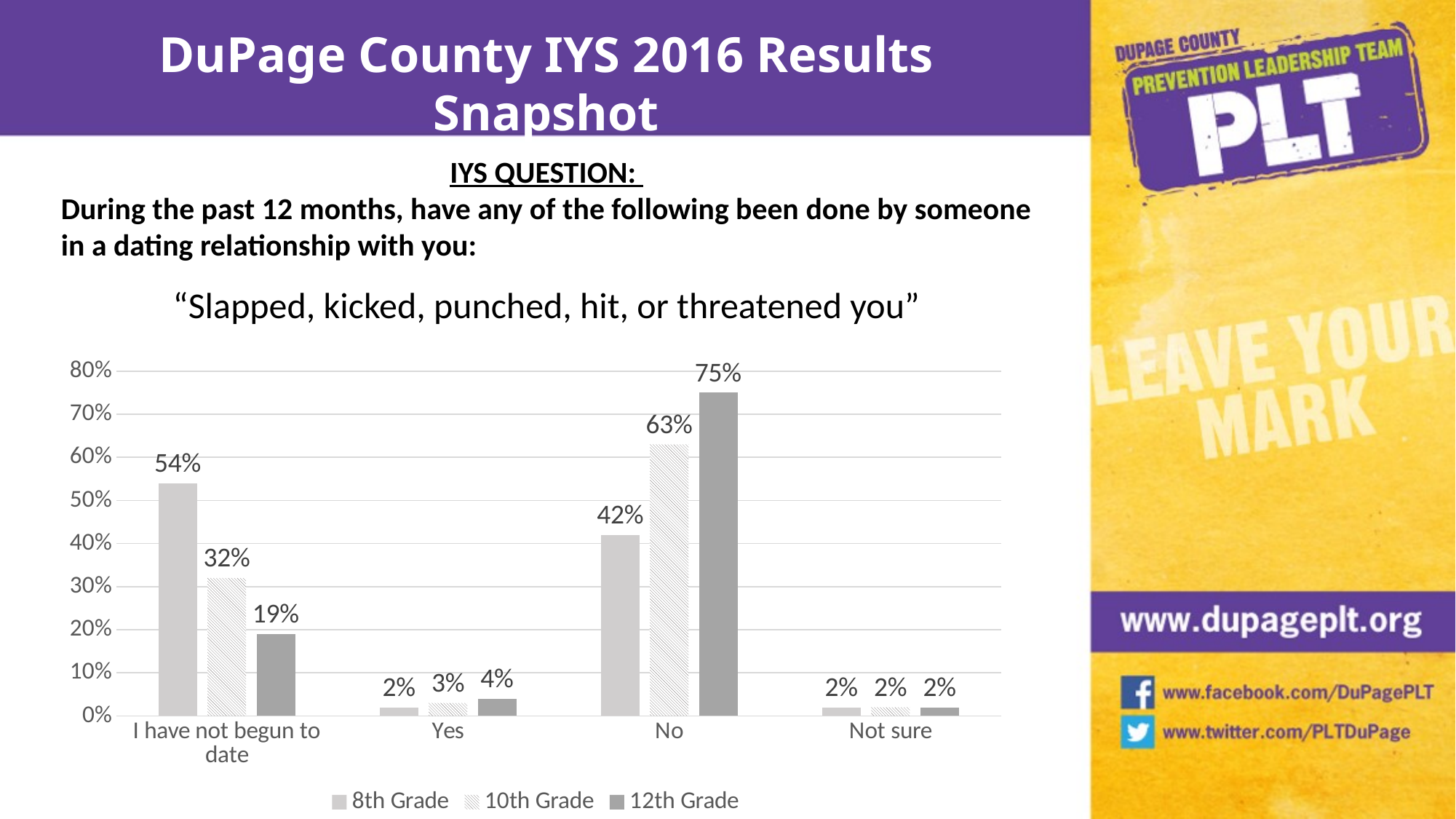
What is the value for 8th Grade in the "I have not begun to date" category? 54% What is the difference between the 12th Grade and 8th Grade values in the "No" category? 33% Which is larger in the "I have not begun to date" category: 8th Grade or 10th Grade? 8th Grade Is the value for 10th Grade in the "No" category greater or less than 50%? greater What kind of chart is shown on the slide? Bar chart How many series does the legend list? 3 How many categories are shown on the x axis? 4 Which category has the highest value for 12th Grade? No Which category has the lowest value for 8th Grade? Yes and Not sure (both 2%) What is the title of the chart? "Slapped, kicked, punched, hit, or threatened you" What is the value for 10th Grade in the "Yes" category? 3% What is the value for 12th Grade in the "No" category? 75%